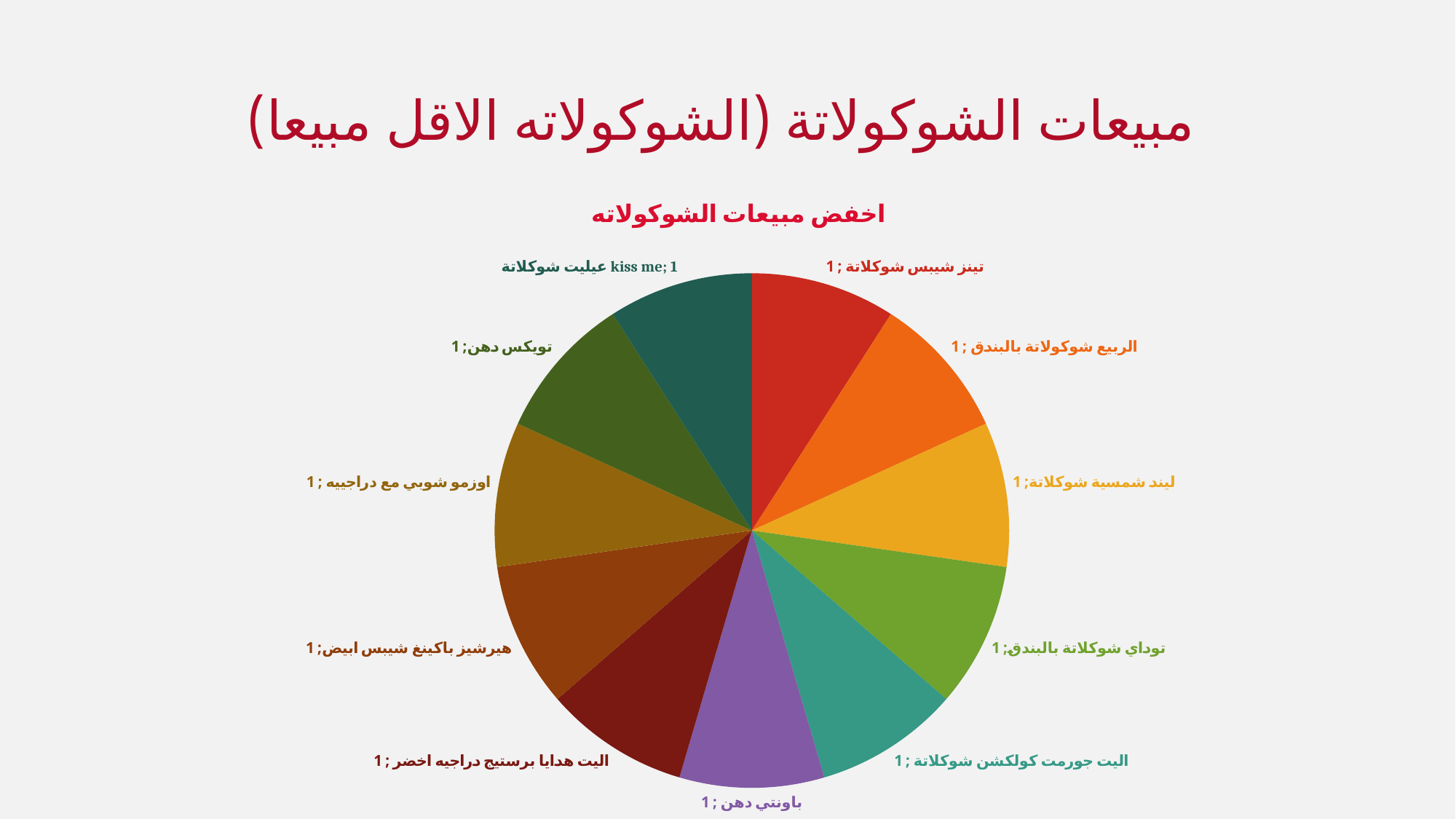
What kind of chart is shown on the slide? Pie chart What is the value shown for باونتي دهن? 1 What is the total of all the slice values in the pie chart? 11 What is the difference between the values for تويكس دهن and اوزمو شوبي مع دراجيه? 0 What is the title of the chart? اخفض مبيعات الشوكولاته How many slices does the pie chart have? 11 What is the value shown for هيرشيز باكينغ شيبس ابيض? 1 What is the value shown for تينز شيبس شوكلاتة? 1 What is the value shown for اليت هدايا برستيج دراجيه اخضر? 1 What is the value shown for ليند شمسية شوكلاتة? 1 What is the title of the slide? مبيعات الشوكولاتة (الشوكولاته الاقل مبيعا) What is the value shown for kiss me عيليت شوكلاتة? 1